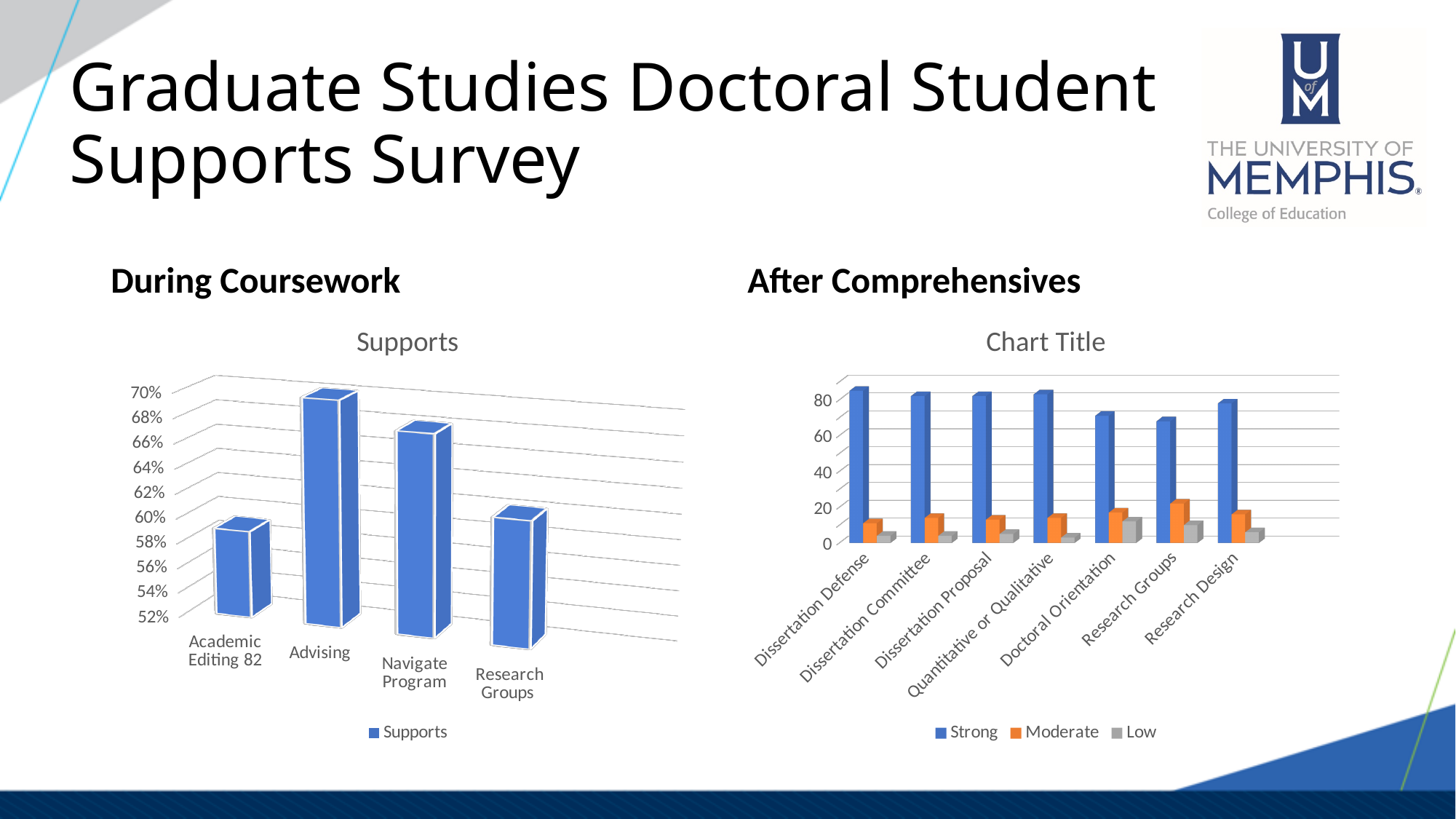
In the 'Supports' chart, which is larger: Navigate Program or Academic Editing 82? Navigate Program In the 'Supports' chart, which category has the highest value? Advising How many categories are shown in the 'Chart Title' chart under 'After Comprehensives'? 7 In the 'Supports' chart, is the value for Research Groups greater or less than 64%? less In the 'Chart Title' chart, is the Strong value for Dissertation Defense greater or less than 80? greater How many series does the legend of the 'Chart Title' chart under 'After Comprehensives' list? 3 In the 'Chart Title' chart, which category has the highest Strong value? Dissertation Defense How many categories are shown in the 'Supports' chart? 4 What are the legend entries of the 'Chart Title' chart under 'After Comprehensives'? Strong, Moderate, Low What type of chart is the 'Supports' chart under 'During Coursework'? bar chart In the 'Chart Title' chart, which category has the highest Moderate value? Research Groups In the 'Supports' chart, is the value for Advising greater or less than 66%? greater